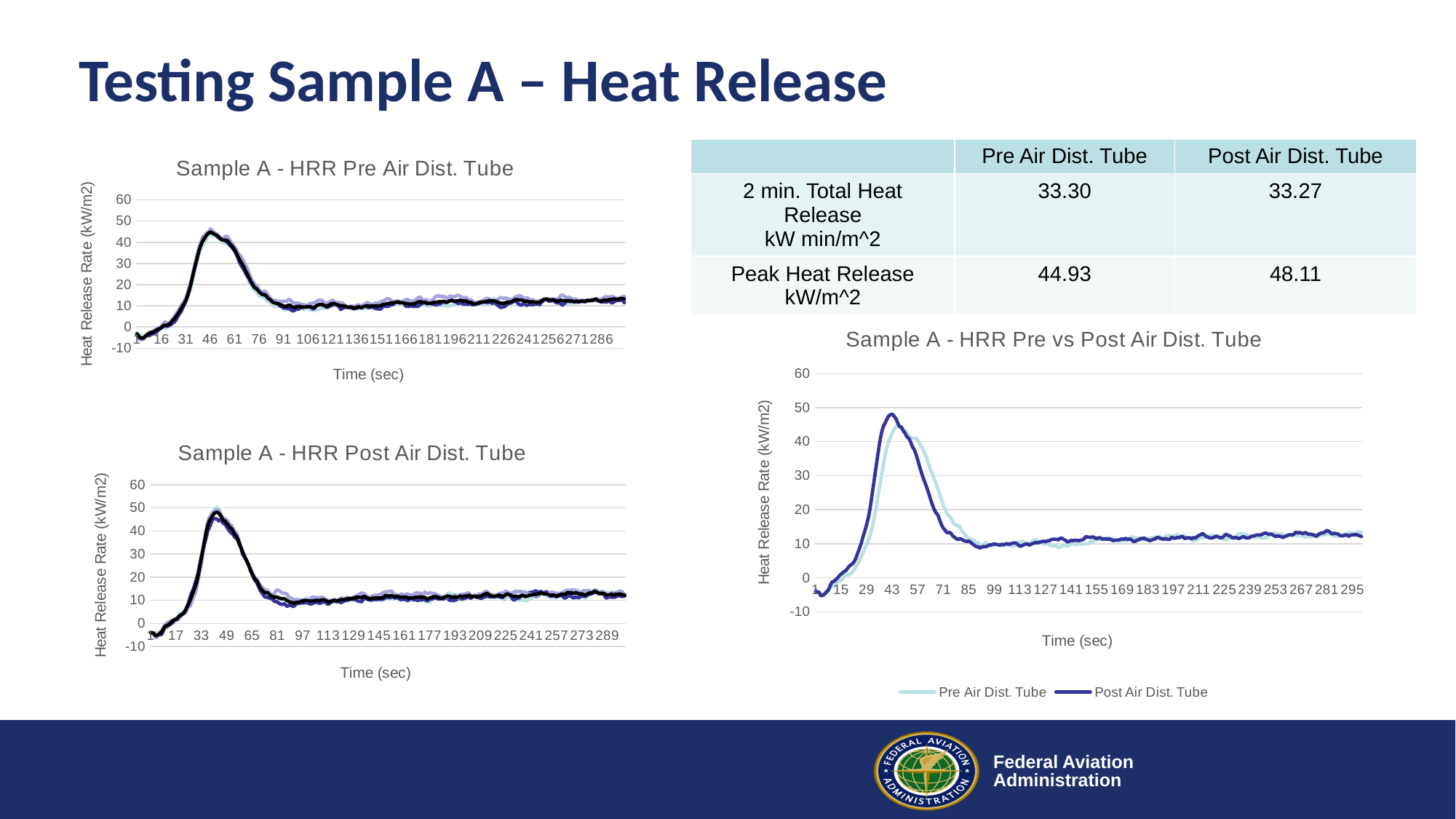
What is the highest tick value shown on the y-axis of the 'Sample A - HRR Pre Air Dist. Tube' chart? 60 In the 'Sample A - HRR Pre vs Post Air Dist. Tube' chart, is the Post Air Dist. Tube value at around 200 seconds greater or less than 20? less In the 'Sample A - HRR Pre vs Post Air Dist. Tube' chart, is the peak value of the Post Air Dist. Tube series greater or less than 40? greater In the 'Sample A - HRR Pre Air Dist. Tube' chart, is the peak heat release rate greater or less than 40? greater In the 'Sample A - HRR Pre vs Post Air Dist. Tube' chart, which series reaches the higher peak heat release rate? Post Air Dist. Tube What is the x-axis label of the 'Sample A - HRR Pre vs Post Air Dist. Tube' chart? Time (sec) What kind of chart is 'Sample A - HRR Pre vs Post Air Dist. Tube'? Line chart In the 'Sample A - HRR Pre vs Post Air Dist. Tube' chart, after the peak near 43 seconds, do the values rise or fall as time increases toward 85 seconds? fall How many series does the legend of the 'Sample A - HRR Pre vs Post Air Dist. Tube' chart list? 2